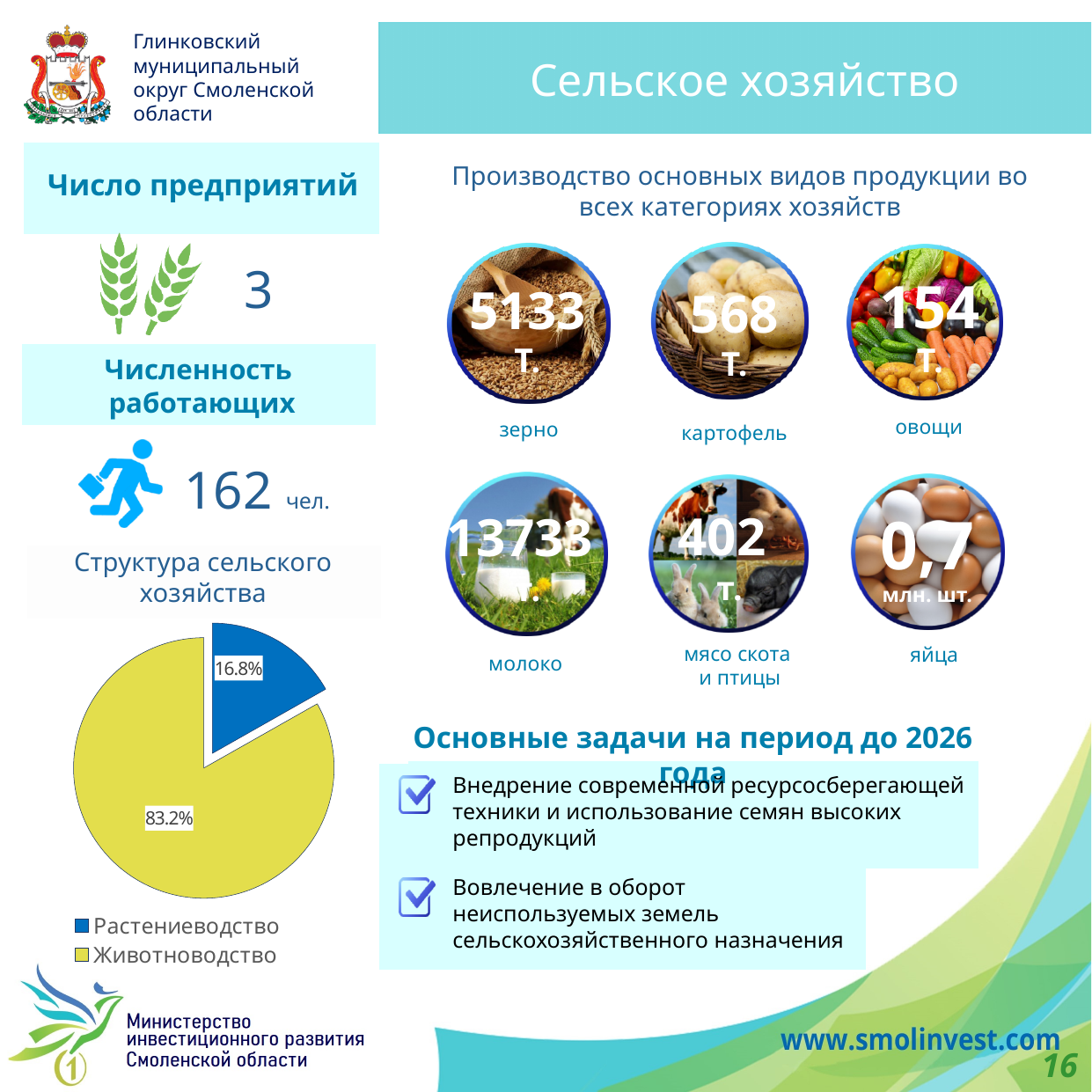
What colour is the Растениеводство slice in the pie chart? Blue Which category has the smallest slice in the pie chart? Растениеводство What kind of chart is shown on the slide? Pie chart What share of the pie chart does Животноводство account for? 83.2% What share of the pie chart does Растениеводство account for? 16.8% What is the value shown on the data label of the yellow slice? 83.2% How many slices does the pie chart have? 2 Which is larger in the pie chart, Растениеводство or Животноводство? Животноводство Which category has the largest slice in the pie chart? Животноводство What is the title of the chart on the slide? Структура сельского хозяйства How many entries does the legend of the pie chart list? 2 What is the difference in percentage points between the Животноводство and Растениеводство slices? 66.4%